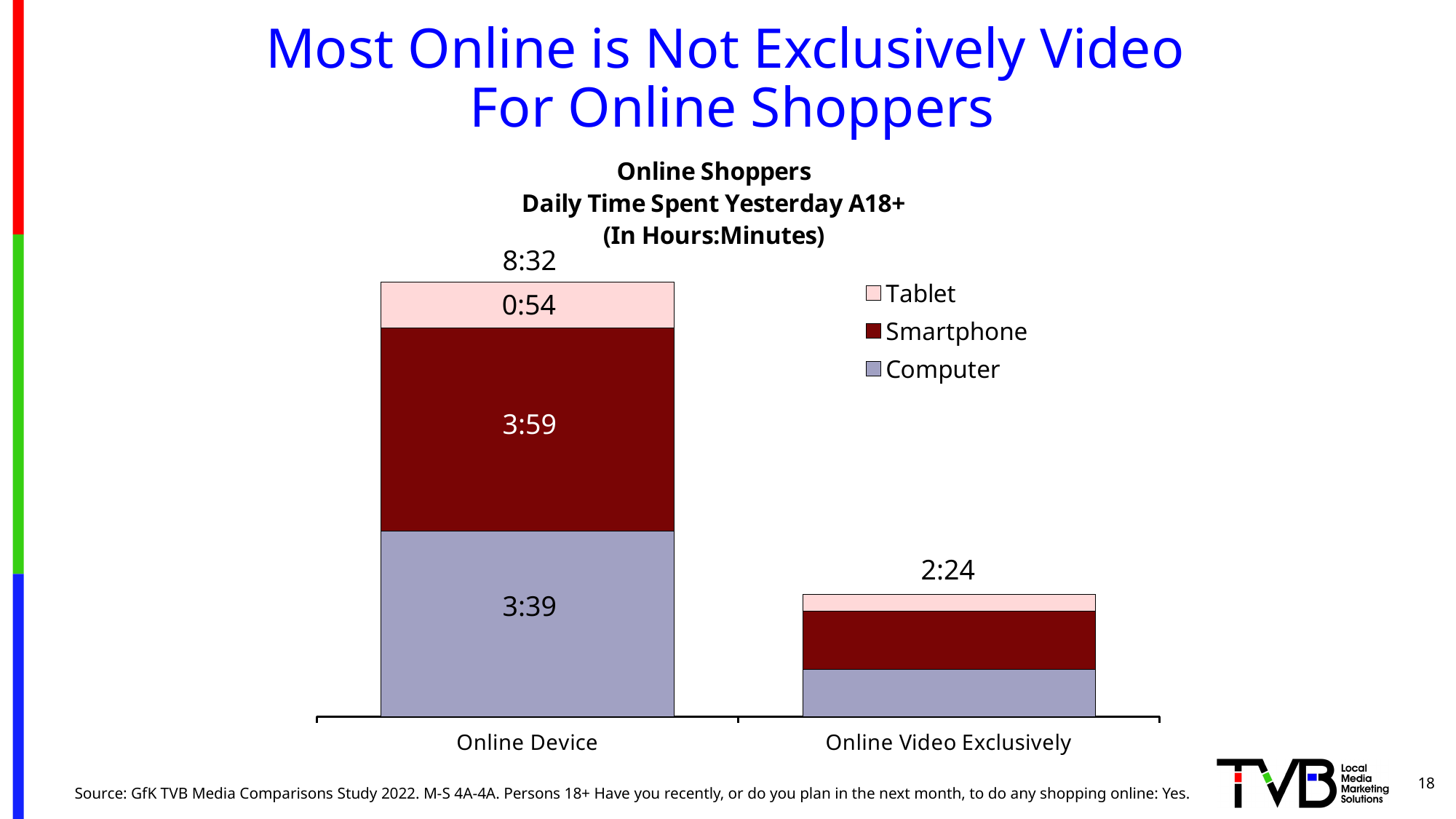
What is the Computer value for Online Device? 3:39 What is the Smartphone value for Online Device? 3:59 What is the Tablet value for Online Device? 0:54 What is the total daily time spent for Online Video Exclusively? 2:24 What is the difference between the Online Device total and the Online Video Exclusively total? 6:08 What is the difference between the Smartphone and Computer values for Online Device? 0:20 Which device accounts for the largest share of time in the Online Device bar? Smartphone How many series does the chart's legend list? 3 What is the total of the stacked bar for Online Device? 8:32 Which category has the higher total daily time spent, Online Device or Online Video Exclusively? Online Device What type of chart is shown on the slide? stacked bar chart How many categories are shown on the x axis of the chart? 2